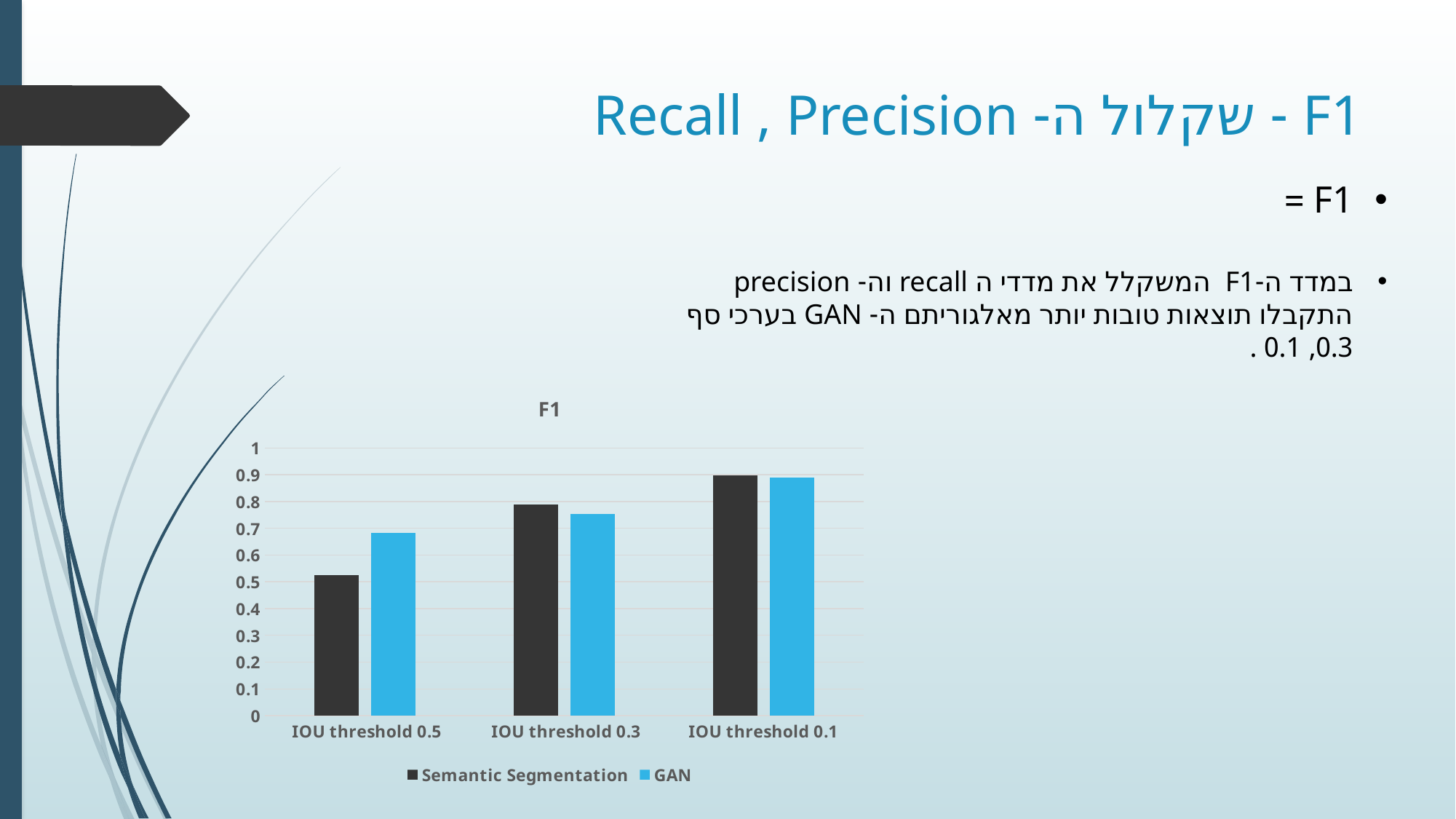
Is the GAN value for IOU threshold 0.5 greater or less than 0.6? greater Is the Semantic Segmentation value for IOU threshold 0.5 greater or less than 0.6? less How many categories are shown on the x axis of the chart? 3 What kind of chart is shown on the slide? bar chart How many series does the chart legend list? 2 What is the title of the chart? F1 Is the Semantic Segmentation value for IOU threshold 0.1 greater or less than 0.8? greater For which category is the Semantic Segmentation value lowest? IOU threshold 0.5 Which series is shown in light blue in the chart? GAN At IOU threshold 0.5, which series has the larger value, Semantic Segmentation or GAN? GAN Do the Semantic Segmentation values rise or fall from IOU threshold 0.5 to IOU threshold 0.1? rise